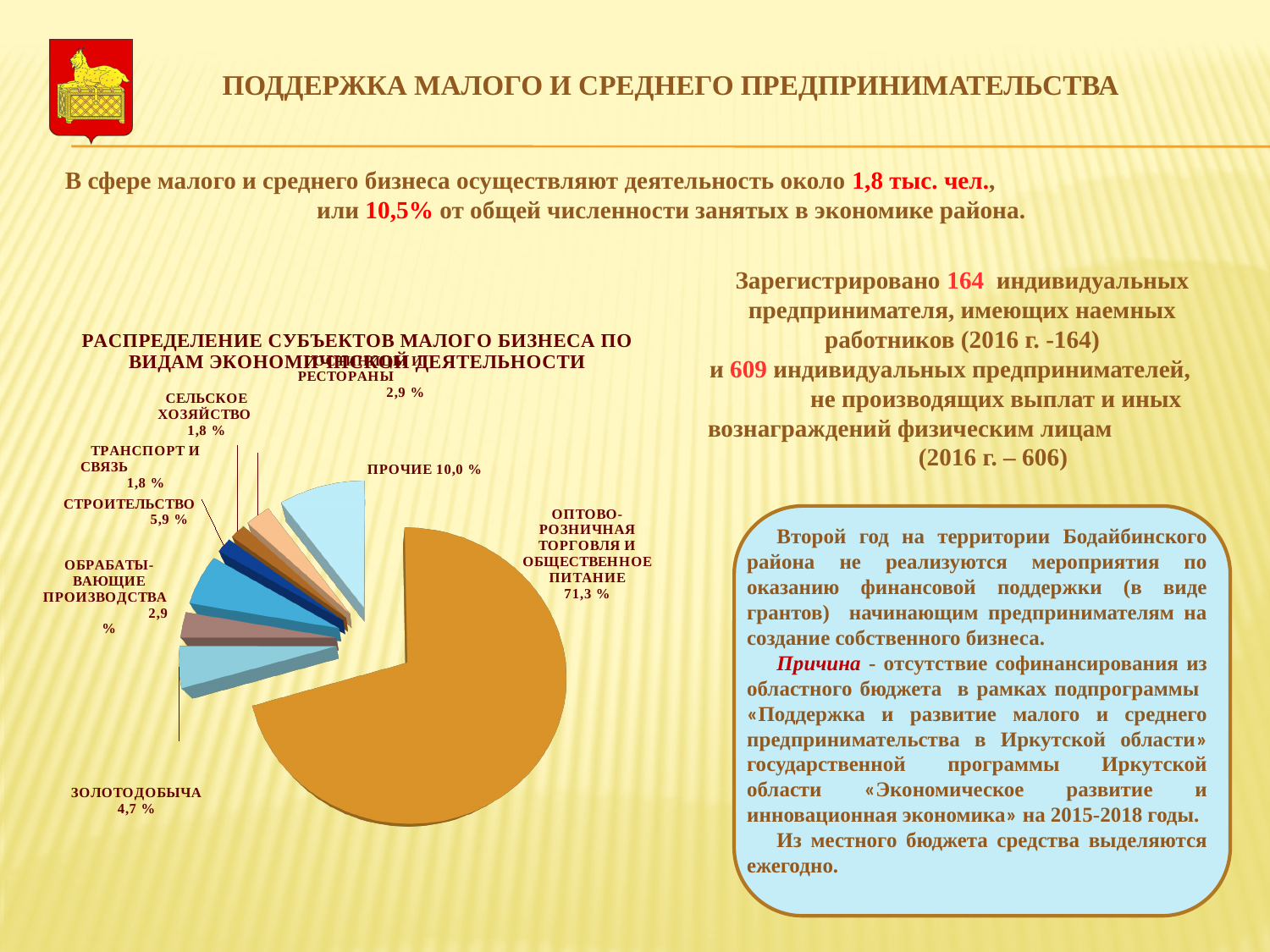
What type of chart is shown on the slide? Pie chart What share does Золотодобыча have in the pie chart? 4,7 % Which is larger: the share of Строительство or the share of Золотодобыча? Строительство What share does Сельское хозяйство have in the pie chart? 1,8 % What share does Строительство have in the pie chart? 5,9 % Which category has the largest share in the pie chart? Оптово-розничная торговля и общественное питание What is the difference between the share of Прочие and the share of Строительство? 4,1 % What share of small business entities is in Оптово-розничная торговля и общественное питание? 71,3 % What is the title of the pie chart? Распределение субъектов малого бизнеса по видам экономической деятельности Do Транспорт и связь and Сельское хозяйство have the same share in the pie chart? Yes, 1,8 % each How many slices does the pie chart have? 8 What share does Прочие have in the pie chart? 10,0 %